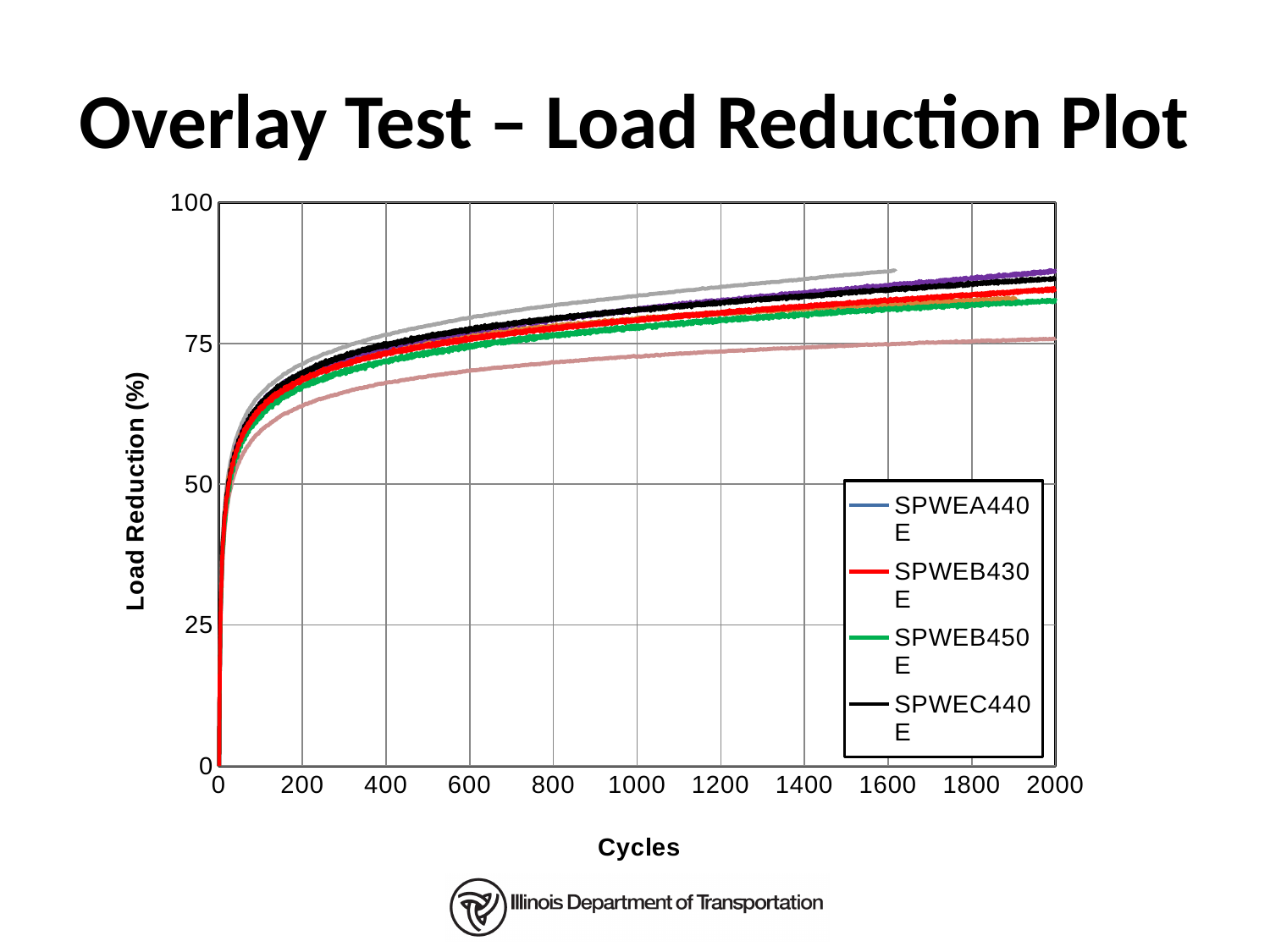
Is the value for SPWEB430E at 200 cycles greater or less than 75? less Is the value for SPWEC440E at 2000 cycles greater or less than 100? less Is the value for SPWEB450E at 200 cycles greater or less than 50? greater What is the label of the y axis? Load Reduction (%) What kind of chart is shown on the slide? line chart Do the values for SPWEC440E rise or fall along the x axis? rise What is the title of the chart on the slide? Overlay Test – Load Reduction Plot How many series does the chart legend list? 4 Do the values for SPWEB430E rise or fall as the number of cycles increases? rise At 2000 cycles, which is larger: the value for SPWEC440E or the value for SPWEB450E? SPWEC440E